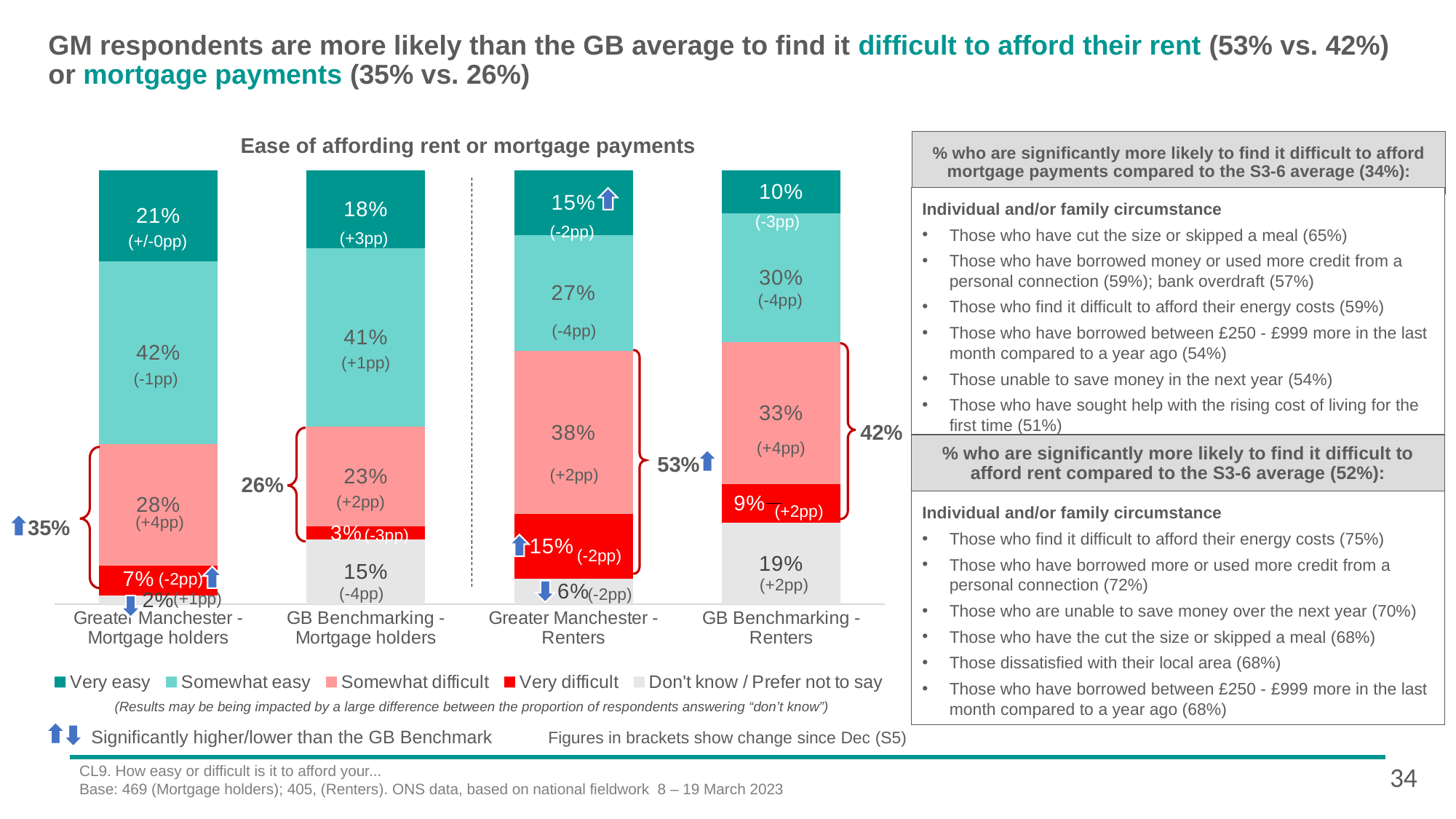
What is the 'Very easy' value for GB Benchmarking - Mortgage holders? 18% What is the 'Very difficult' value for Greater Manchester - Renters? 15% What type of chart is 'Ease of affording rent or mortgage payments'? Stacked bar chart How many series does the legend of the 'Ease of affording rent or mortgage payments' chart list? 5 What is the 'Somewhat easy' value for Greater Manchester - Mortgage holders? 42% Which category has the highest 'Somewhat difficult' value? Greater Manchester - Renters How many categories are shown on the x axis of the 'Ease of affording rent or mortgage payments' chart? 4 Which is larger: the 'Very difficult' value for Greater Manchester - Renters or for GB Benchmarking - Renters? Greater Manchester - Renters Which category has the lowest 'Very easy' value? GB Benchmarking - Renters What is the 'Don't know / Prefer not to say' value for GB Benchmarking - Renters? 19% What colour represents 'Very difficult' in the chart legend? Red What is the difference between the 'Somewhat difficult' values for Greater Manchester - Mortgage holders and GB Benchmarking - Mortgage holders? 5 percentage points